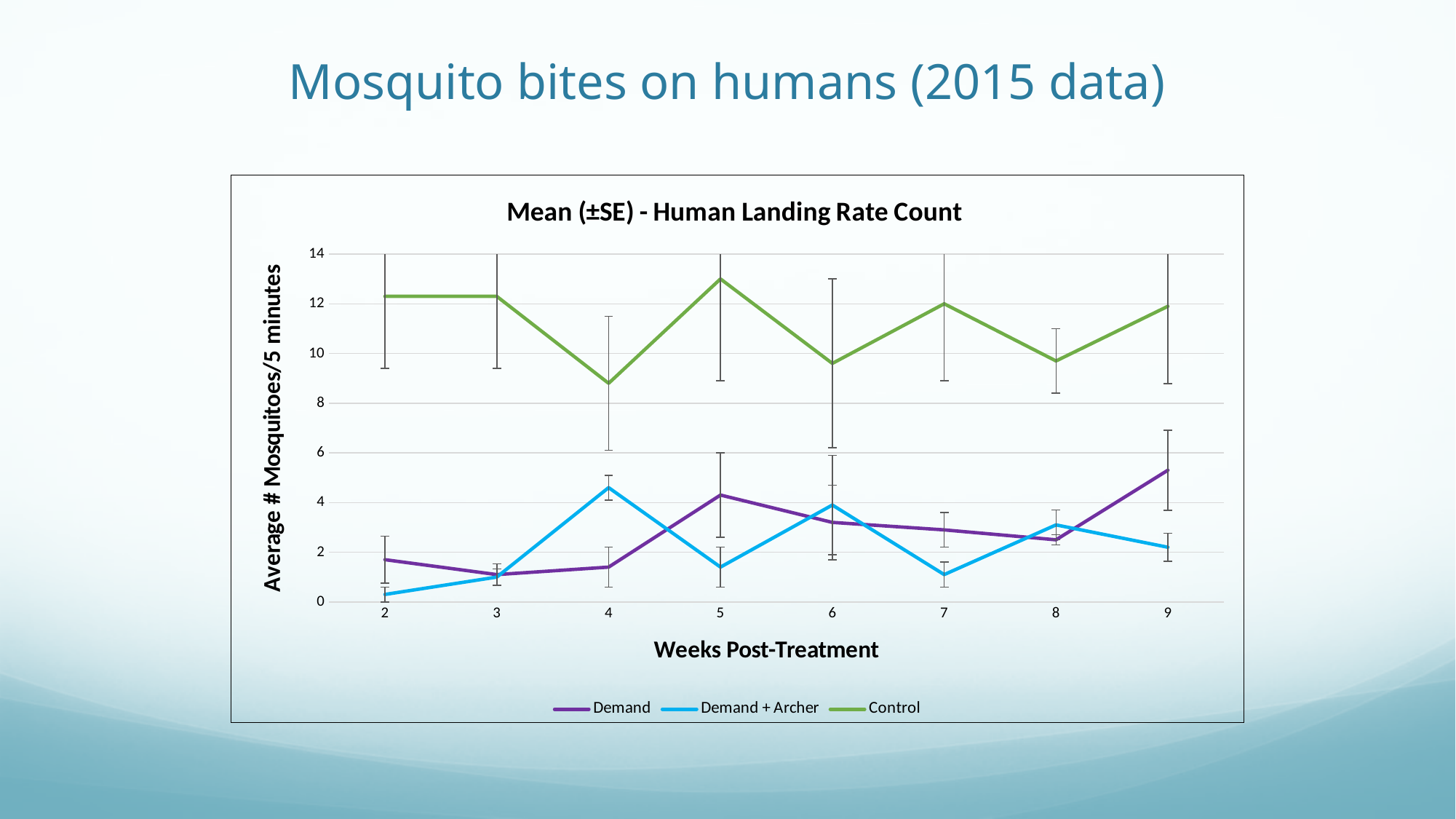
How many series does the legend list? 3 How many weeks are plotted along the x axis? 8 Is the Control value at week 4 greater or less than 10? less Which series has the highest values across all weeks? Control At which week is the Control series at its lowest? 4 At week 4, which series has the higher value: Demand or Demand + Archer? Demand + Archer Is the Demand value at week 9 greater or less than 4? greater Is the Demand + Archer value at week 2 greater or less than 2? less What is the label on the x axis of the chart? Weeks Post-Treatment At week 7, which series has the higher value: Demand or Demand + Archer? Demand What kind of chart is shown on the slide? line chart